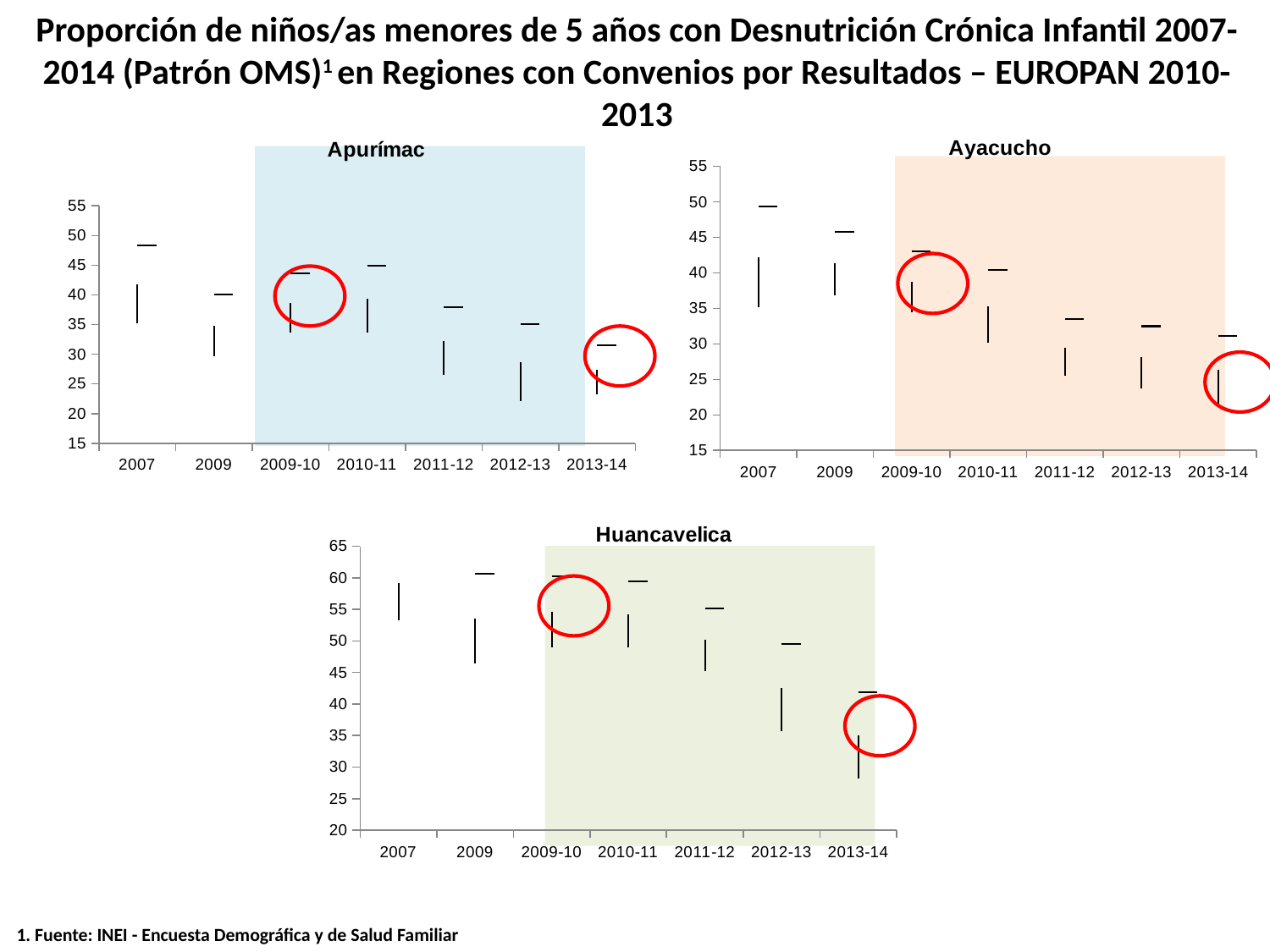
In the Ayacucho chart, which period has the lowest values? 2013-14 Which region's chart is placed at the bottom of the slide? Huancavelica In the Huancavelica chart, do the values generally rise or fall from 2007 to 2013-14? fall In the Apurímac chart, is the highest point shown for 2013-14 greater or less than 35? less In the Huancavelica chart, is the highest point shown for 2009 greater or less than 55? greater How many charts are shown on the slide? 3 In the Apurímac chart, how many periods are shown on the x axis? 7 In the Ayacucho chart, is the highest point shown for 2013-14 greater or less than 35? less In the Apurímac chart, do the values generally rise or fall from 2007 to 2013-14? fall In the Huancavelica chart, how many periods are shown on the x axis? 7 In the Ayacucho chart, do the values generally rise or fall from 2007 to 2013-14? fall